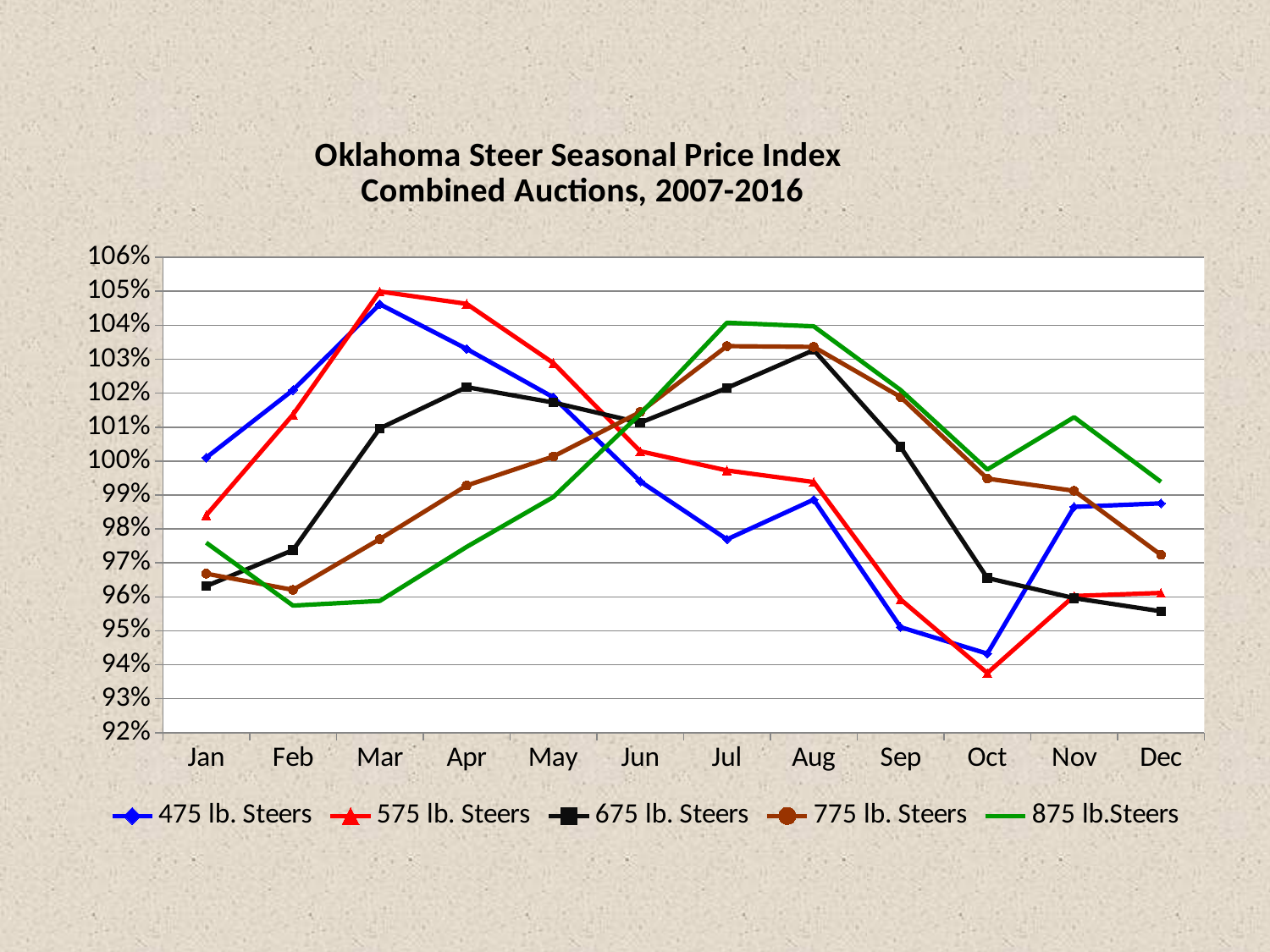
Is the value for 875 lb. Steers in Jul greater or less than 103%? greater In which month does the 575 lb. Steers series reach its highest value? Mar In Jan, which series has the higher value: 475 lb. Steers or 575 lb. Steers? 475 lb. Steers What is the title of the chart? Oklahoma Steer Seasonal Price Index Combined Auctions, 2007-2016 In which month does the 575 lb. Steers series reach its lowest value? Oct What kind of chart is shown on the slide? Line chart How many months are plotted along the x axis? 12 How many series does the legend list? 5 In which month does the 475 lb. Steers series reach its lowest value? Oct In which month does the 675 lb. Steers series reach its highest value? Aug Does the 875 lb. Steers series rise or fall from Feb to Jul? Rise Is the value for 575 lb. Steers in Oct greater or less than 95%? less